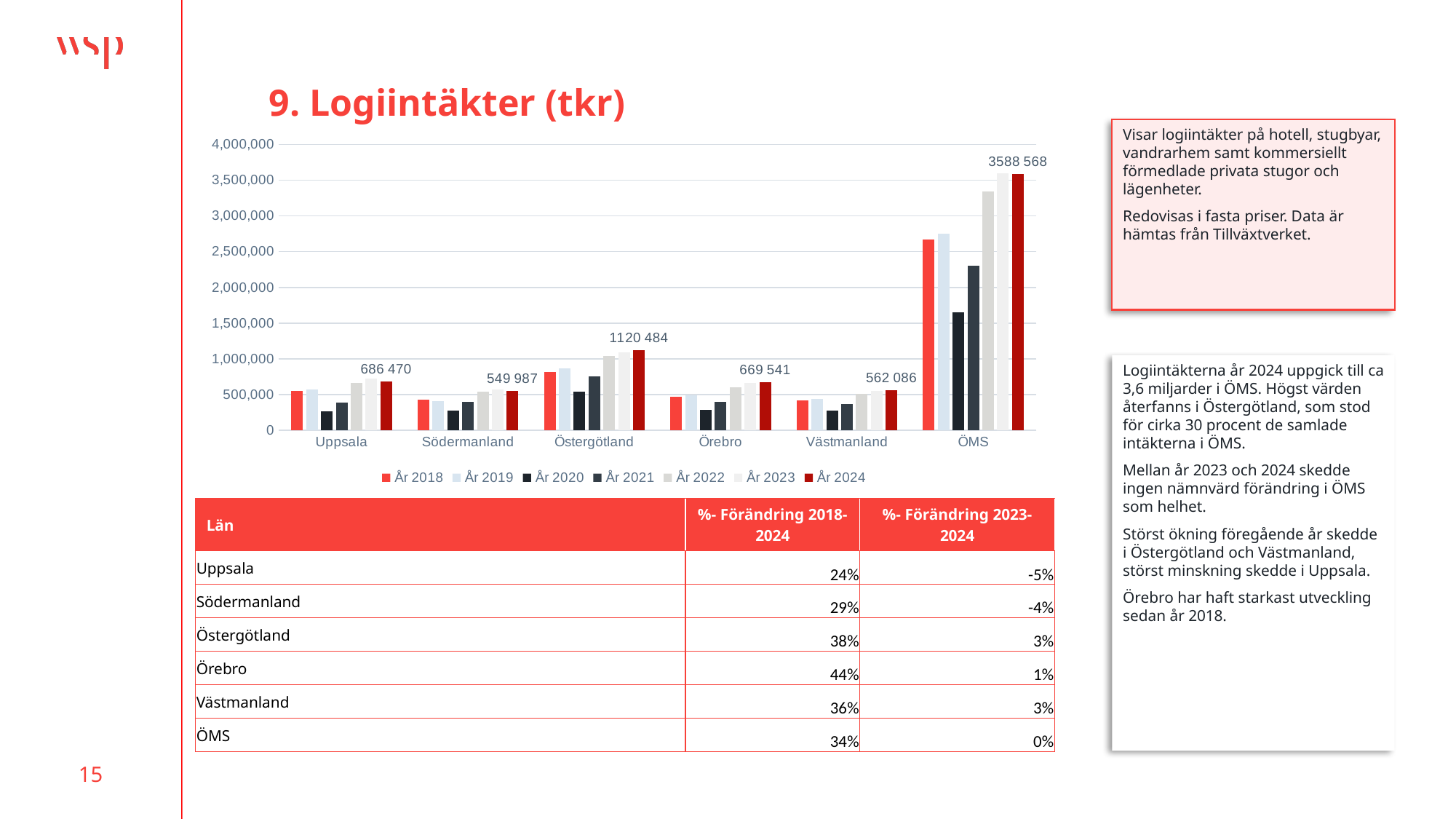
What is the value for Uppsala in År 2024? 686 470 What type of chart is shown on the slide? bar chart Is the value for ÖMS in År 2020 greater or less than 2,000,000? less Which is larger in År 2024: Uppsala or Örebro? Uppsala How many categories are shown on the x axis? 6 How many series does the legend list? 7 Is the value for Östergötland in År 2018 greater or less than 500,000? greater Which category has the highest value in År 2024? ÖMS What is the value for Östergötland in År 2024? 1120 484 What is the difference between the År 2024 values for Östergötland and Uppsala? 434 014 Which category has the lowest value in År 2024? Södermanland What is the value for ÖMS in År 2024? 3588 568